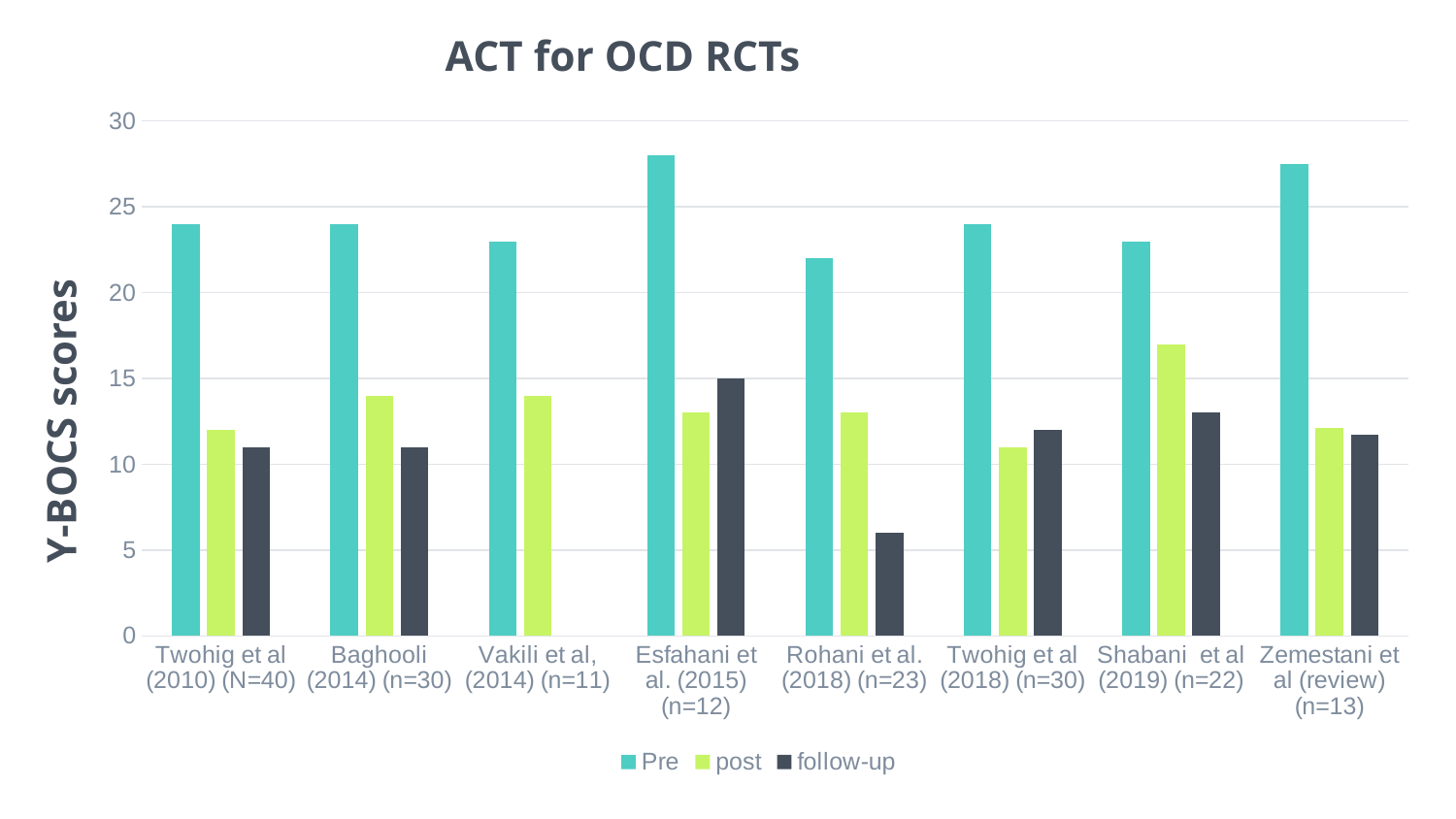
Is the follow-up value for Rohani et al. (2018) greater or less than 10? less How many studies (categories) are shown on the x axis? 8 How many series does the legend list? 3 What is the label on the y axis? Y-BOCS scores Which is larger for Twohig et al (2018): the post value or the follow-up value? follow-up Is the post value for Shabani et al (2019) greater or less than 15? greater What kind of chart is shown on the slide? bar chart Is the Pre value for Esfahani et al. (2015) greater or less than 25? greater Which study has the highest follow-up score? Esfahani et al. (2015) (n=12) What is the title of the chart? ACT for OCD RCTs Which study has the highest post score? Shabani et al (2019) (n=22) Which study has the lowest follow-up score? Rohani et al. (2018) (n=23)